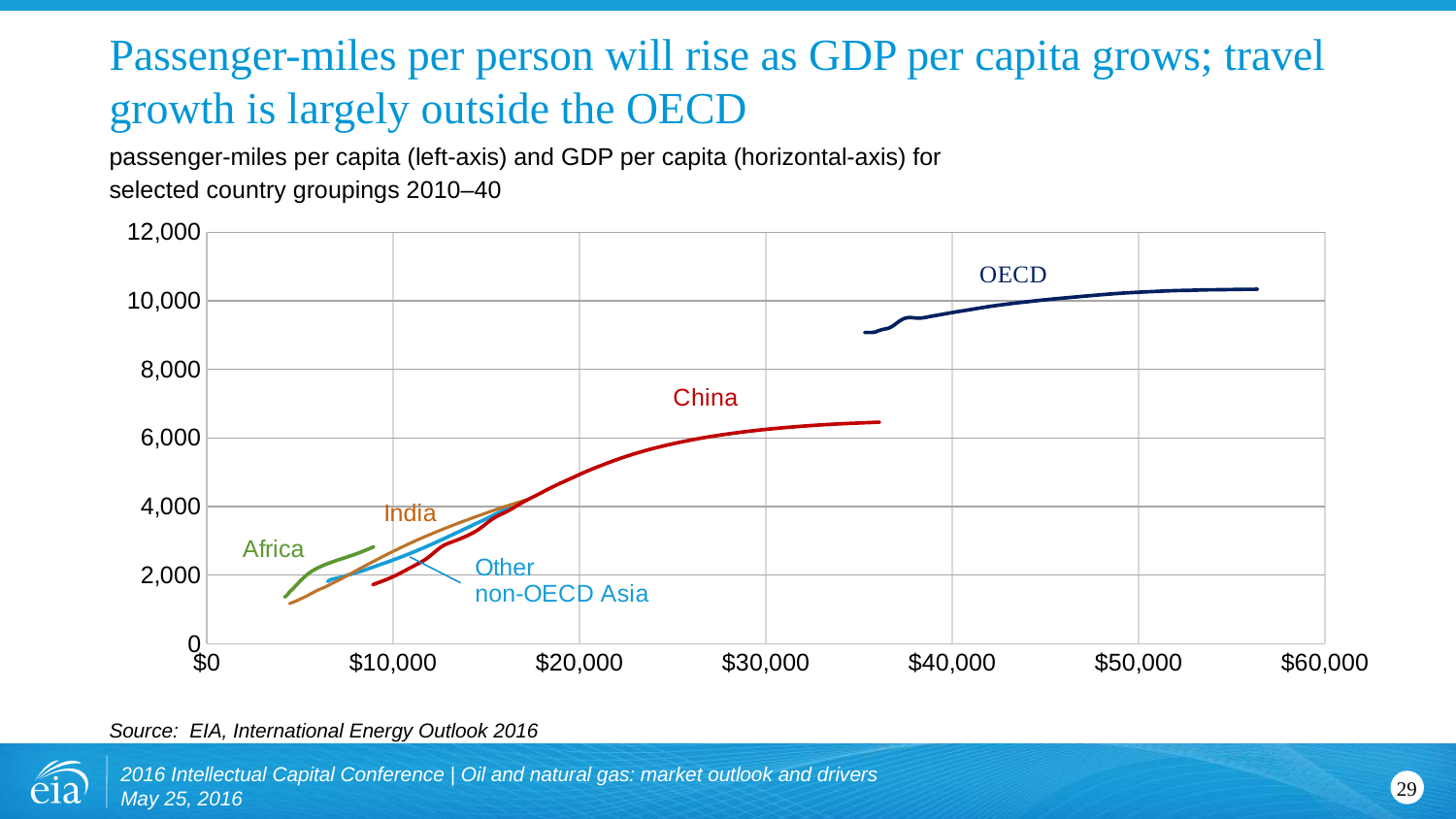
Which has higher passenger-miles per capita, OECD or China? OECD Is the lowest value on the OECD line greater or less than 8,000 passenger-miles per capita? greater Which country grouping has the highest passenger-miles per capita on the chart? OECD What is the source cited for the chart? EIA, International Energy Outlook 2016 Does passenger-miles per capita rise or fall as GDP per capita increases along the China line? rise What is the maximum value shown on the horizontal (GDP per capita) axis? $60,000 What kind of chart is shown on the slide? line chart How many country groupings are plotted as lines on the chart? 5 Is the highest value reached by the China line greater or less than 8,000 passenger-miles per capita? less Is the highest value reached by the China line greater or less than 6,000 passenger-miles per capita? greater